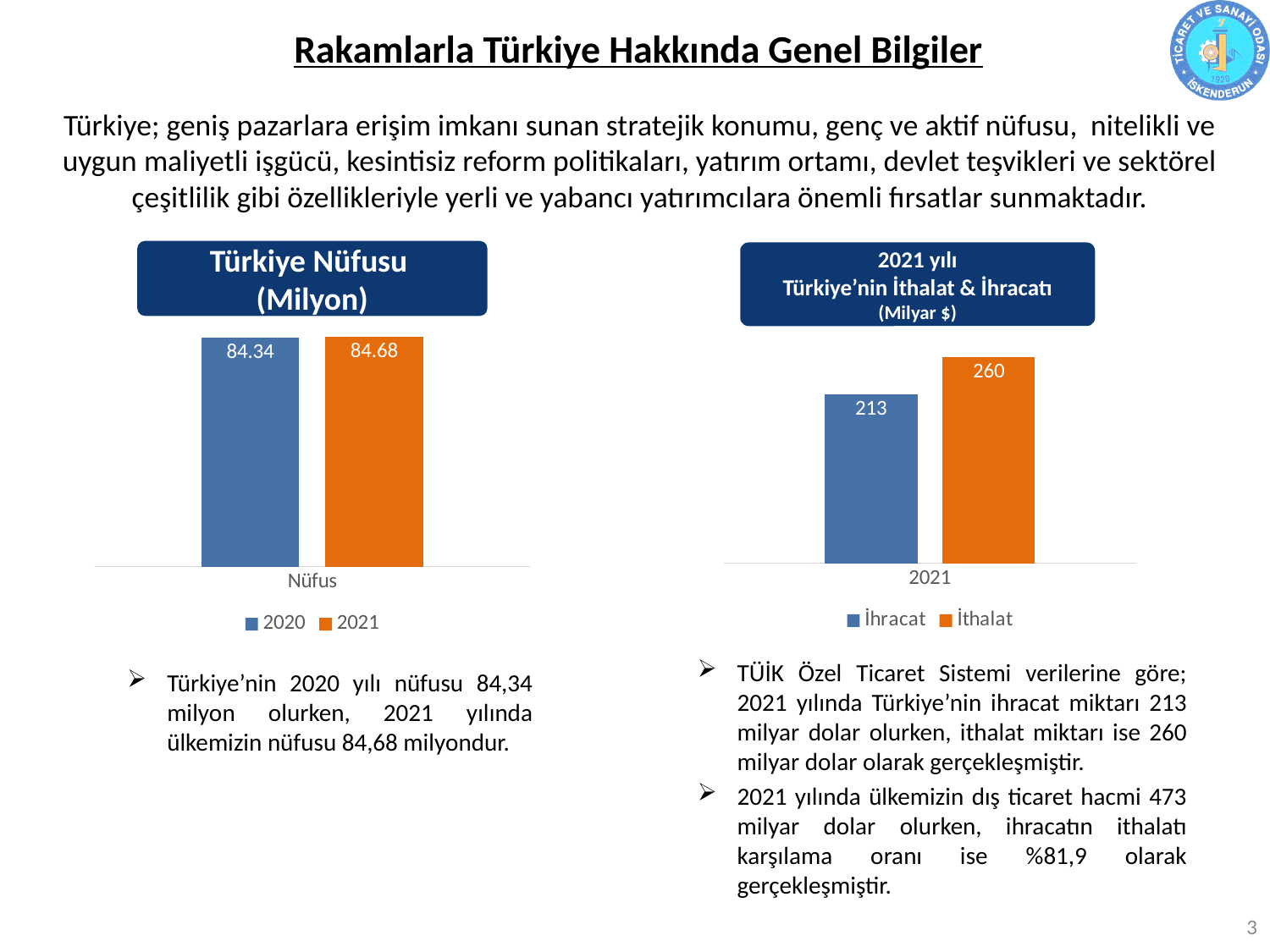
In the '2021 yılı Türkiye'nin İthalat & İhracatı (Milyar $)' chart, what is the value for İthalat? 260 In the '2021 yılı Türkiye'nin İthalat & İhracatı (Milyar $)' chart, which series has the higher value? İthalat In the 'Türkiye Nüfusu (Milyon)' chart, what is the category label on the x axis? Nüfus What kind of chart is the 'Türkiye Nüfusu (Milyon)' chart? bar chart In the 'Türkiye Nüfusu (Milyon)' chart, what is the value for 2020? 84.34 In the 'Türkiye Nüfusu (Milyon)' chart, how many series does the legend list? 2 In the '2021 yılı Türkiye'nin İthalat & İhracatı (Milyar $)' chart, what colour is the İthalat bar? orange In the 'Türkiye Nüfusu (Milyon)' chart, what is the value for 2021? 84.68 In the '2021 yılı Türkiye'nin İthalat & İhracatı (Milyar $)' chart, what is the difference between İthalat and İhracat? 47 In the '2021 yılı Türkiye'nin İthalat & İhracatı (Milyar $)' chart, how many series does the legend list? 2 In the 'Türkiye Nüfusu (Milyon)' chart, what is the difference between the 2021 and 2020 values? 0.34 In the '2021 yılı Türkiye'nin İthalat & İhracatı (Milyar $)' chart, what is the value for İhracat? 213